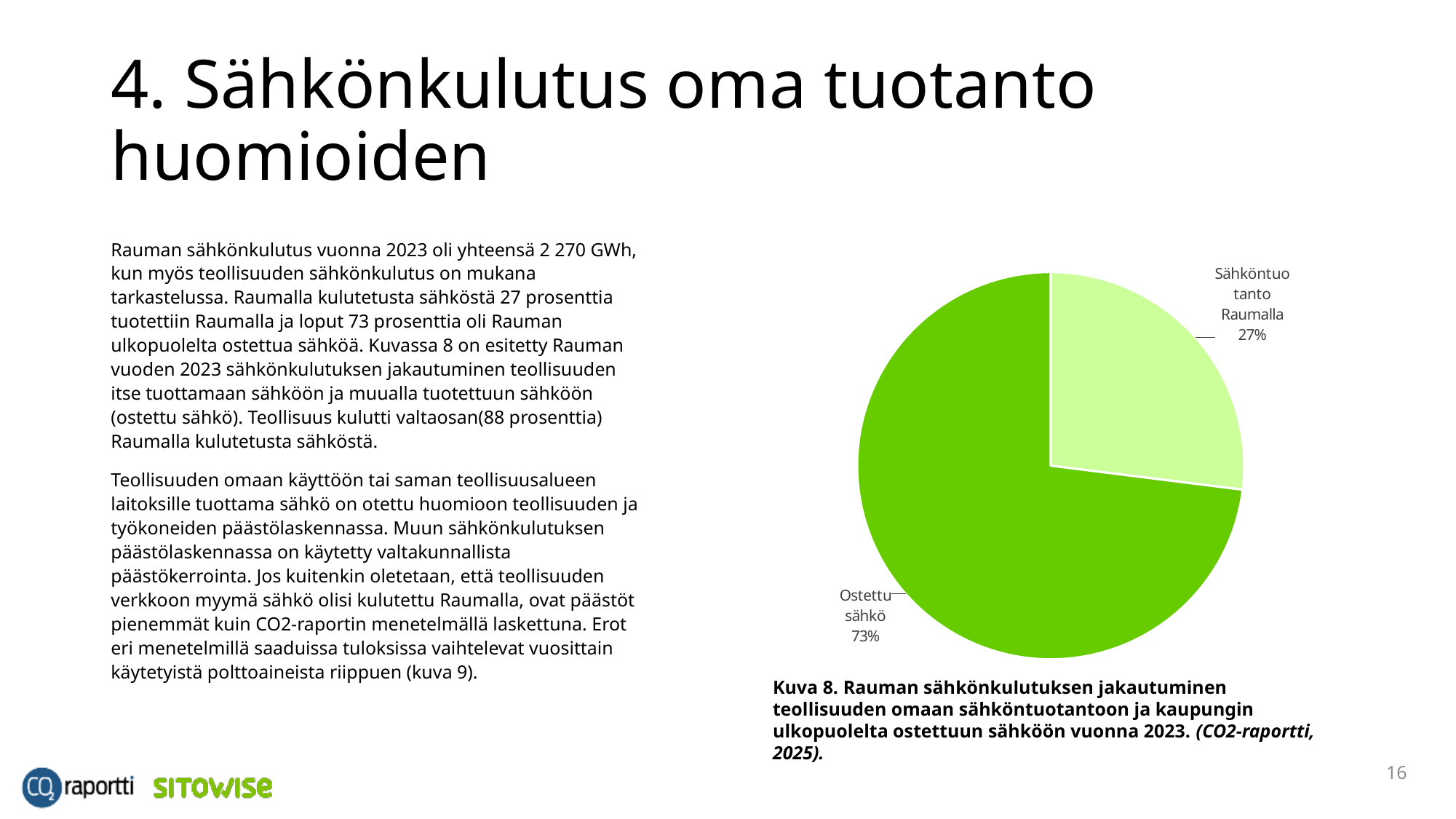
What colour is the "Ostettu sähkö" slice? dark green What colour is the "Sähköntuotanto Raumalla" slice? light green What share of the pie does "Sähköntuotanto Raumalla" represent? 27% What kind of chart is shown on the slide? pie chart Which slice of the pie is the smallest? Sähköntuotanto Raumalla How many slices does the pie chart have? 2 Which is larger, the share for "Ostettu sähkö" or the share for "Sähköntuotanto Raumalla"? Ostettu sähkö Which slice of the pie is the largest? Ostettu sähkö What is the difference in percentage points between the "Ostettu sähkö" slice and the "Sähköntuotanto Raumalla" slice? 46 What share of the pie does "Ostettu sähkö" represent? 73% What is the combined share of the two slices in the pie chart? 100%